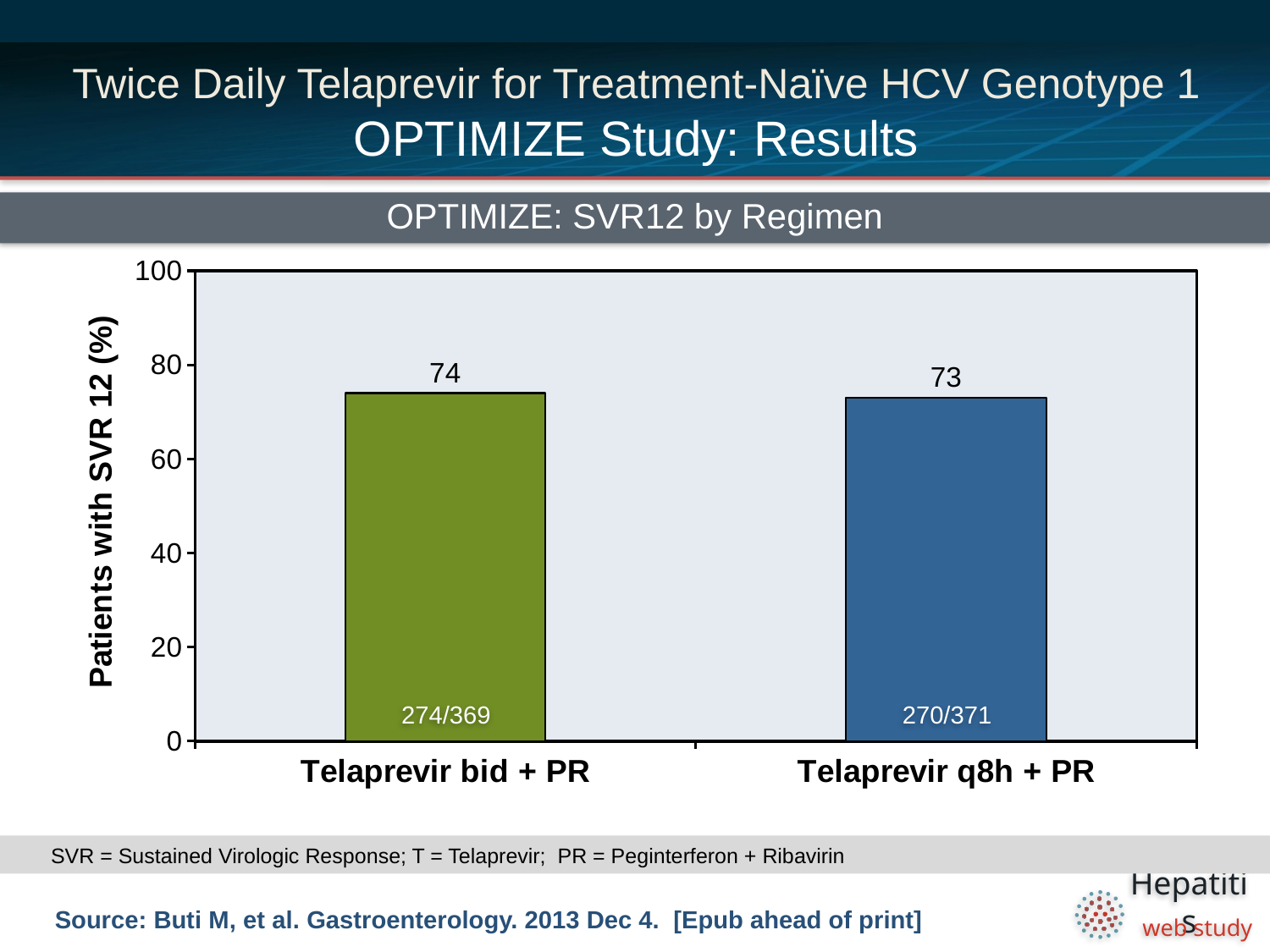
Which regimen has the higher SVR12 rate according to the data labels? Telaprevir bid + PR Is the SVR12 rate for Telaprevir q8h + PR greater or less than 80? less What fraction of patients is shown inside the Telaprevir bid + PR bar? 274/369 Is the SVR12 rate for Telaprevir bid + PR greater or less than 60? greater Which regimen has the lower SVR12 rate according to the data labels? Telaprevir q8h + PR What fraction of patients is shown inside the Telaprevir q8h + PR bar? 270/371 What is the difference in SVR12 rate between Telaprevir bid + PR and Telaprevir q8h + PR? 1 What is the title of the chart? OPTIMIZE: SVR12 by Regimen What is the SVR12 rate for Telaprevir q8h + PR? 73 What is the SVR12 rate for Telaprevir bid + PR? 74 How many regimens are plotted in the chart? 2 What type of chart is shown on the slide? Bar chart